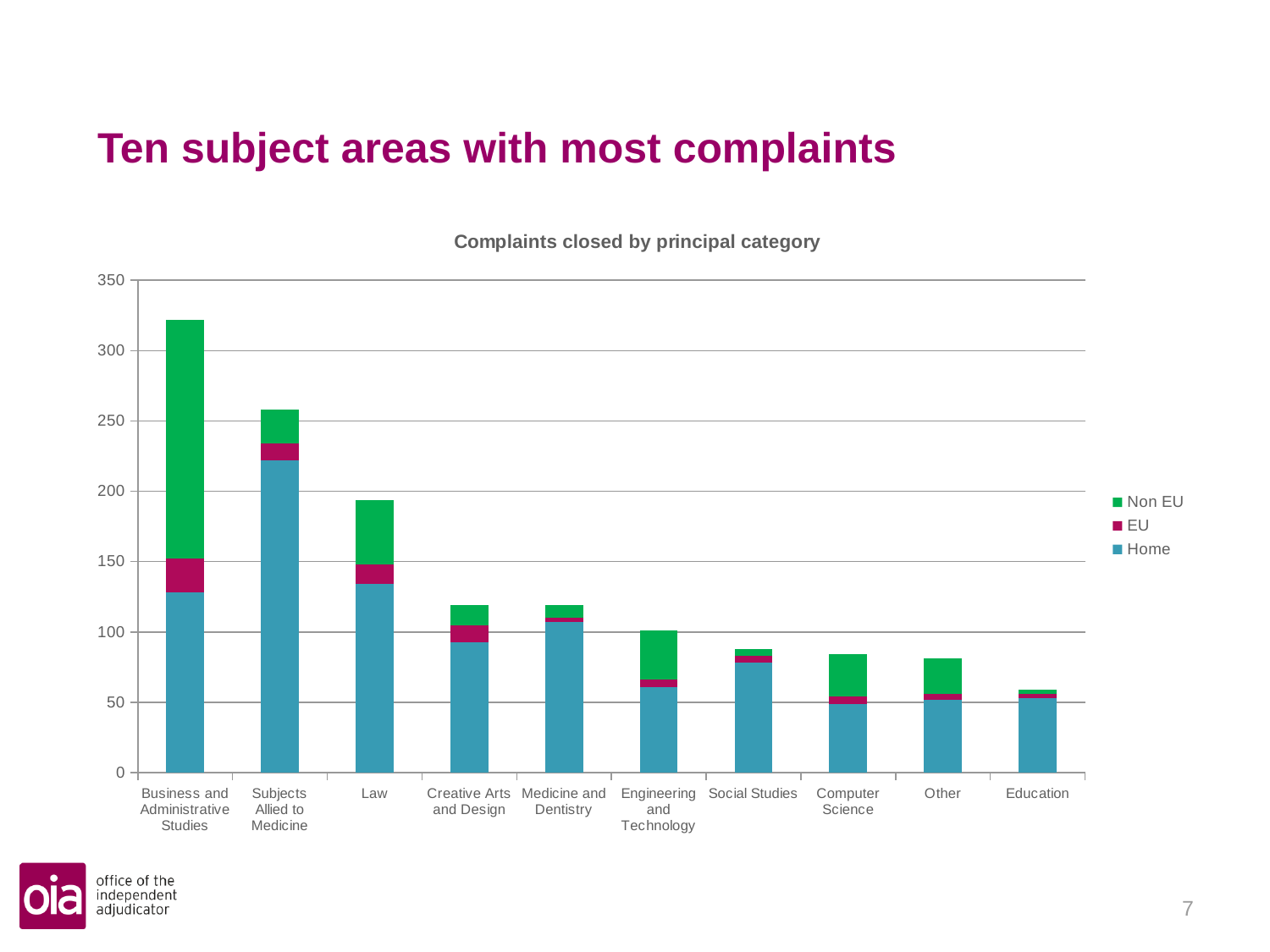
What kind of chart is shown on the slide? Stacked bar chart What is the title of the chart? Complaints closed by principal category Is the total bar for Social Studies greater or less than 100? less Is the Home segment for Subjects Allied to Medicine greater or less than 200? greater Which has a larger total bar, Law or Creative Arts and Design? Law How many series does the chart's legend list? 3 Is the total bar for Business and Administrative Studies greater or less than 300? greater Do the total bar heights generally rise or fall moving from left to right along the x axis? Fall Which subject area has the lowest total number of complaints closed? Education How many subject areas are shown on the x axis of the chart? 10 Which subject area has the highest total number of complaints closed? Business and Administrative Studies